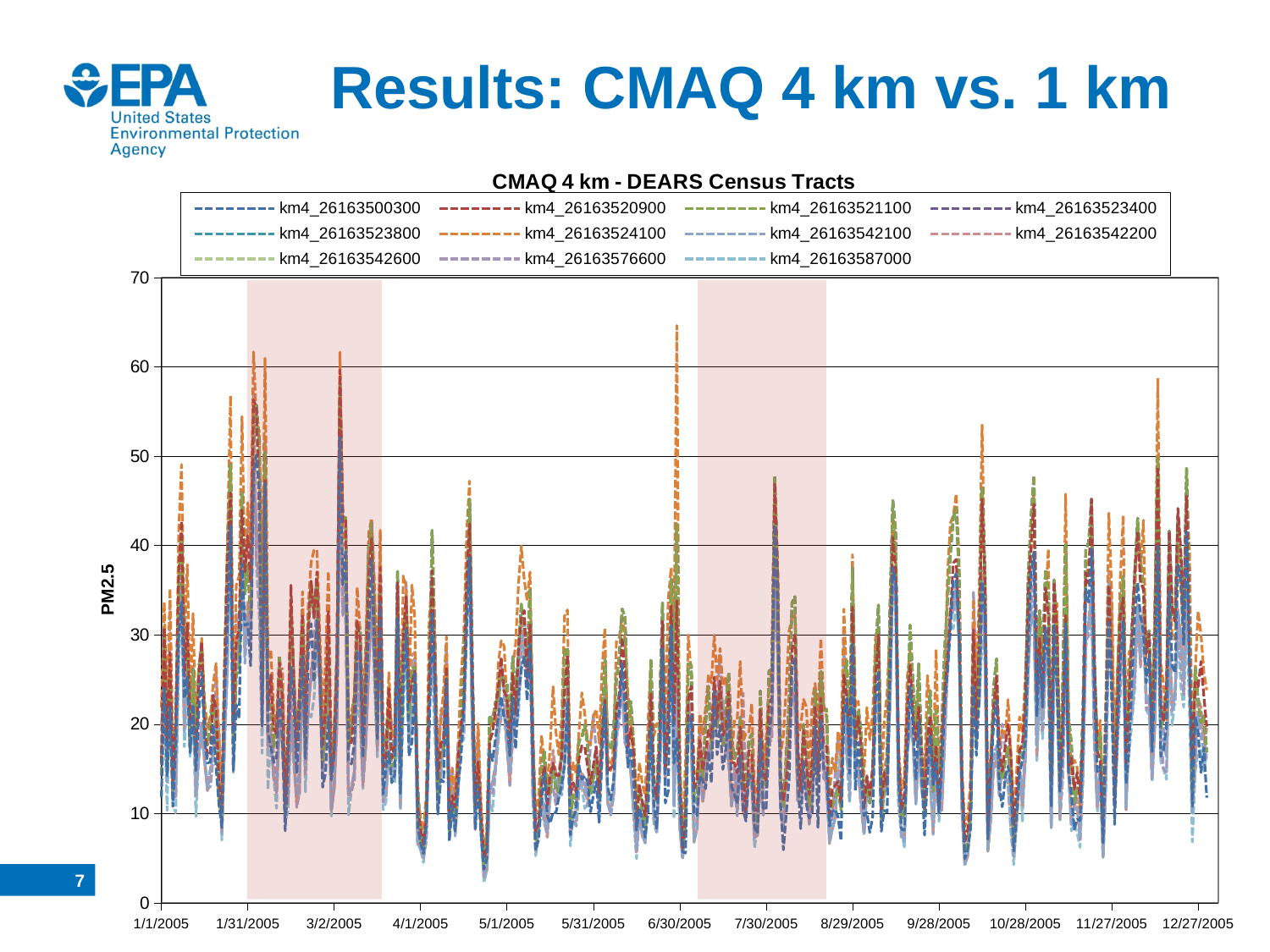
Is the lowest value plotted in the chart greater or less than 10? less Is the highest peak plotted near 6/30/2005 greater or less than 60? greater How many series does the legend of the chart list? 11 What is the title of the chart? CMAQ 4 km - DEARS Census Tracts Is the highest peak plotted between 1/31/2005 and 3/2/2005 greater or less than 50? greater How many date labels are shown along the x axis of the chart? 13 What is the label on the vertical axis of the chart? PM2.5 What kind of chart is shown on the slide? line chart